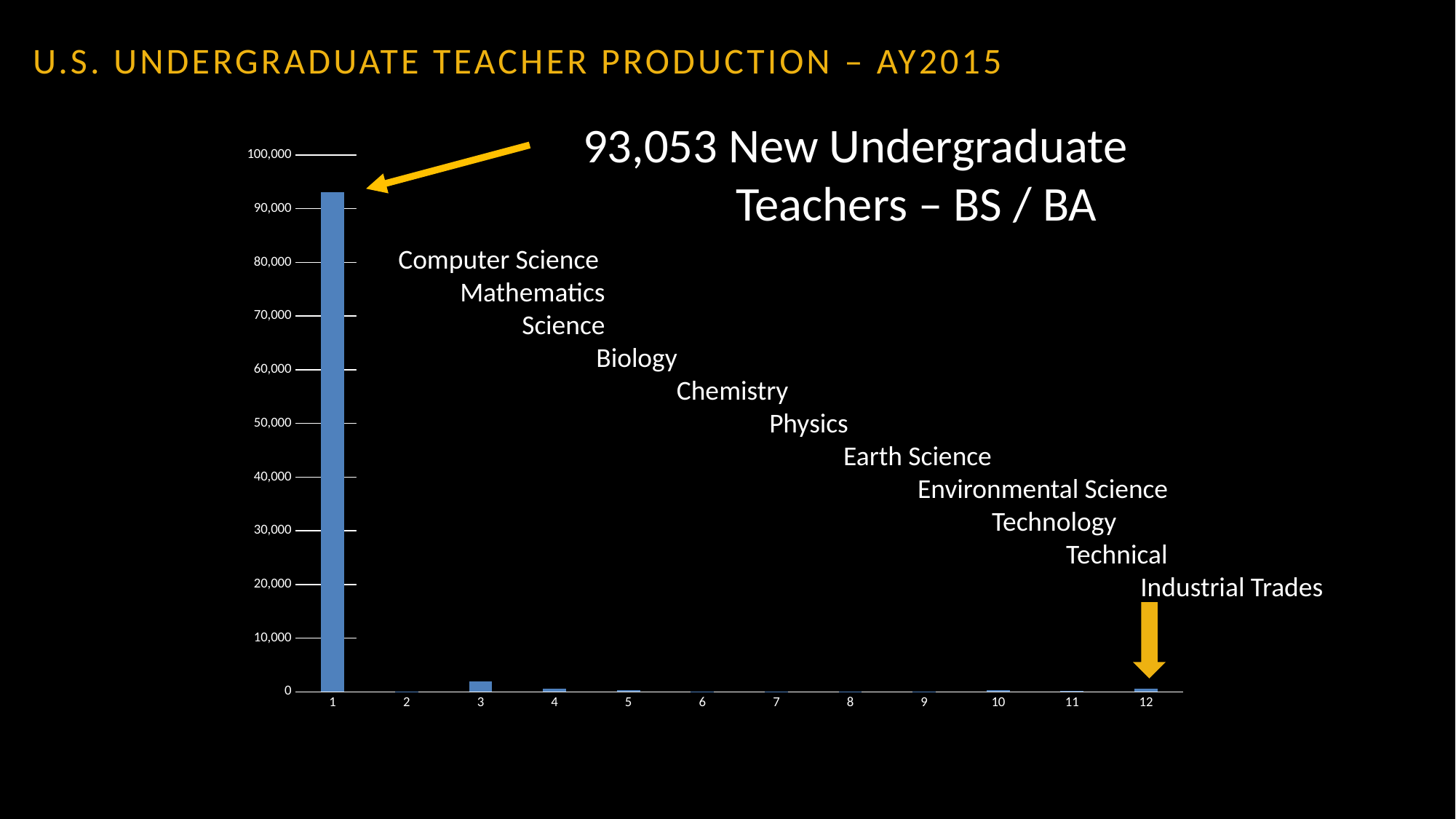
Which is larger, the value for category 1 or the value for category 3? 1 What value does the arrow annotation give for the bar at category 1? 93,053 Which is larger, the value for category 3 or the value for category 2? 3 Is the value for category 3 greater or less than 10,000? less Which category on the x axis does the arrow labeled "Industrial Trades" point to? 12 What is the title of the slide containing the chart? U.S. Undergraduate Teacher Production – AY2015 Which category has the highest bar in the chart? 1 How many categories are plotted along the x axis of the chart? 12 What kind of chart is shown on the slide? bar chart Is the value for category 1 greater or less than 90,000? greater Is the value for category 12 greater or less than 10,000? less